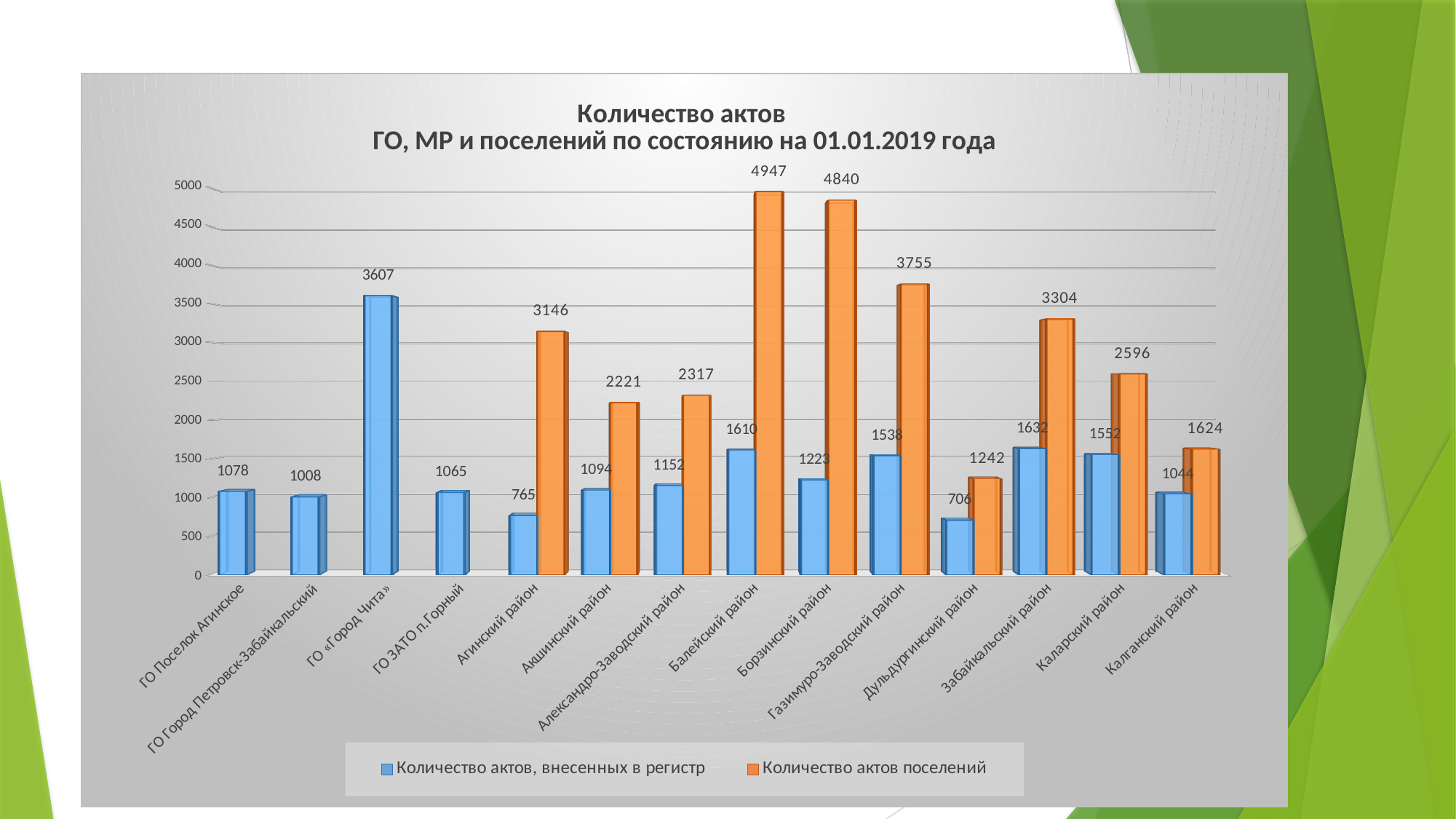
Which has a larger value for 'Количество актов, внесенных в регистр': Забайкальский район or Каларский район? Забайкальский район What kind of chart is shown on the slide? Bar chart Which category has the lowest value for 'Количество актов, внесенных в регистр'? Дульдургинский район How many series does the legend list? 2 Which series is shown in orange in the legend? Количество актов поселений What is the value of 'Количество актов поселений' for Балейский район? 4947 What is the value of 'Количество актов поселений' for Дульдургинский район? 1242 How many categories are shown on the x axis? 14 Which category has the highest value for 'Количество актов поселений'? Балейский район What is the difference between the 'Количество актов поселений' values for Балейский район and Борзинский район? 107 What is the value of 'Количество актов, внесенных в регистр' for ГО «Город Чита»? 3607 For Балейский район, what is the difference between 'Количество актов поселений' and 'Количество актов, внесенных в регистр'? 3337